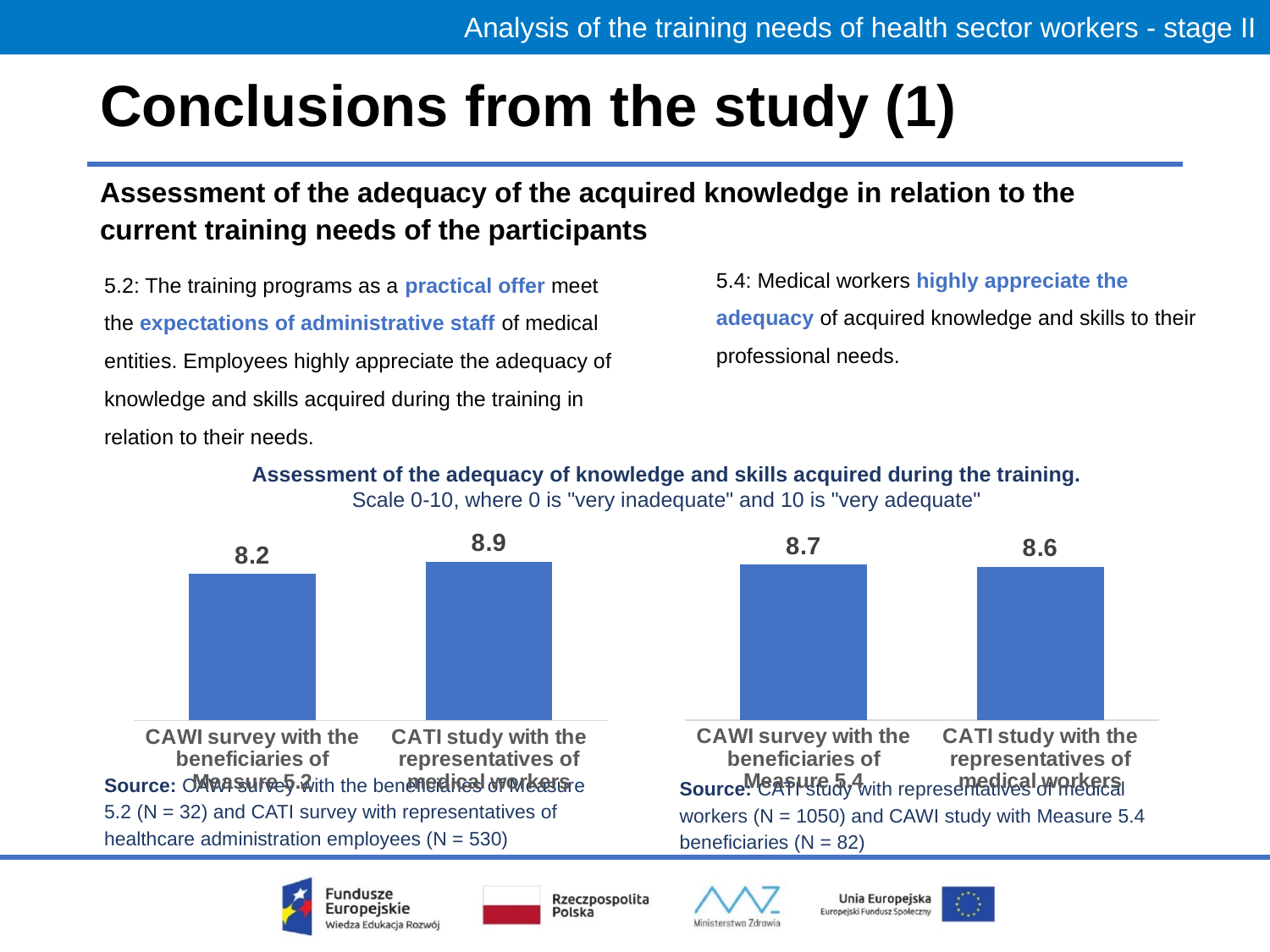
What scale is used for the assessment shown in the charts? 0-10, where 0 is "very inadequate" and 10 is "very adequate" In the right chart, what is the value for the CATI study with the representatives of medical workers? 8.6 In the left chart, which category has the highest value? CATI study with the representatives of medical workers In the left chart, what is the difference between the CATI study value and the CAWI survey value? 0.7 What type of chart is the left chart? Bar chart In the right chart, what is the difference between the CAWI survey value and the CATI study value? 0.1 In the left chart, what is the value for the CATI study with the representatives of medical workers? 8.9 In the left chart, what is the value for the CAWI survey with the beneficiaries of Measure 5.2? 8.2 In the left chart, which is larger: the CAWI survey with the beneficiaries of Measure 5.2 or the CATI study with the representatives of medical workers? CATI study with the representatives of medical workers How many bars are shown in the right chart? 2 In the right chart, which category has the lowest value? CATI study with the representatives of medical workers In the right chart, what is the value for the CAWI survey with the beneficiaries of Measure 5.4? 8.7